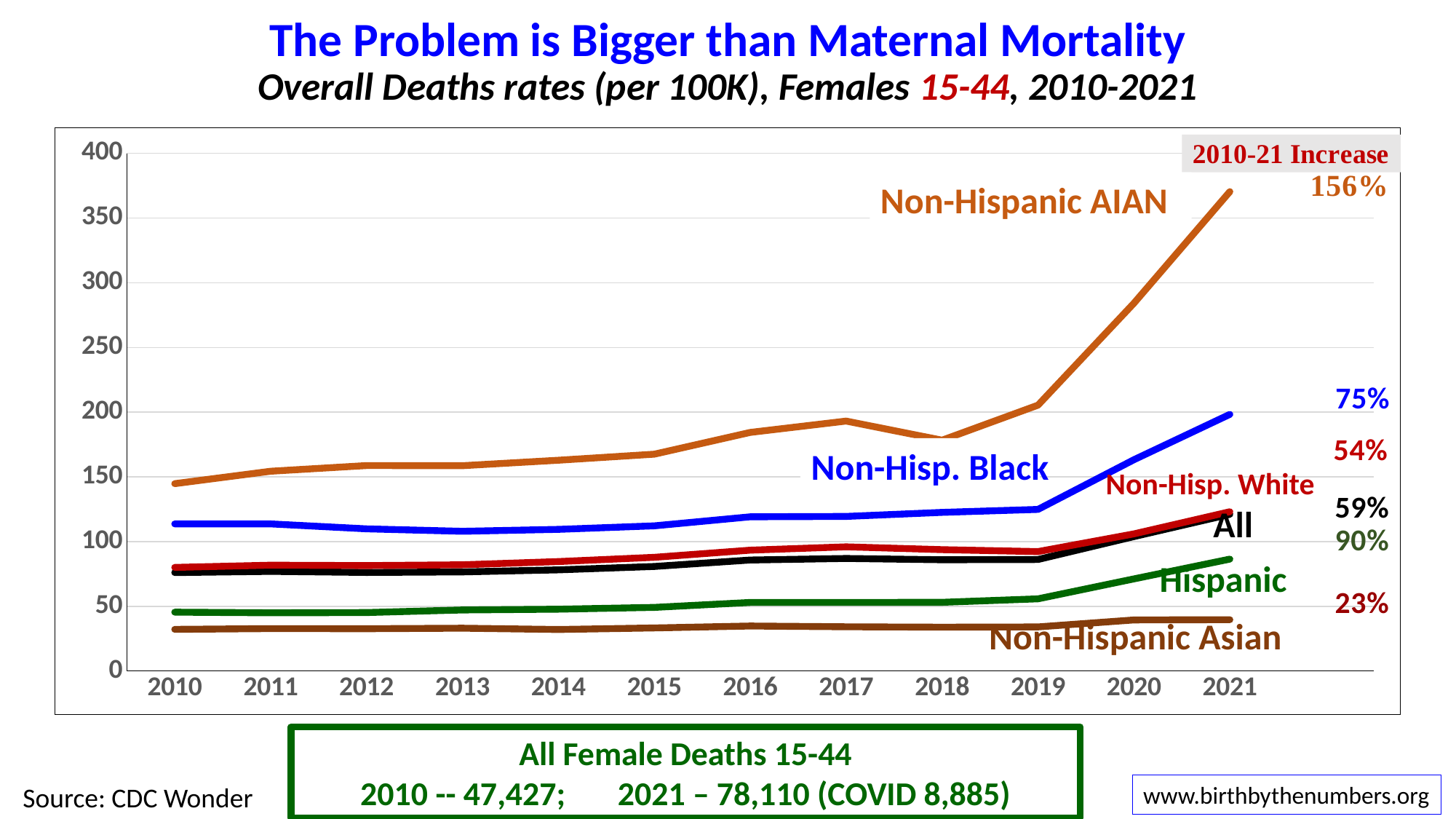
Which group has the lowest death rate line throughout the chart? Non-Hispanic Asian What is the 2010-21 increase shown for the All group? 59% How many years are plotted along the x axis? 12 Which group has the highest death rate line throughout the chart? Non-Hispanic AIAN What is the 2010-21 increase shown for Hispanic females? 90% In 2021, which is higher: the Non-Hisp. Black rate or the Non-Hisp. White rate? Non-Hisp. Black What kind of chart is shown on the slide? line chart Is the Non-Hispanic Asian death rate in 2021 greater or less than 50? less What is the 2010-21 increase shown for Non-Hispanic Asian females? 23% What is the 2010-21 increase shown for Non-Hispanic AIAN? 156% Is the Non-Hispanic AIAN death rate in 2021 greater or less than 350? greater Does the Non-Hispanic AIAN death rate rise or fall from 2019 to 2021? rise